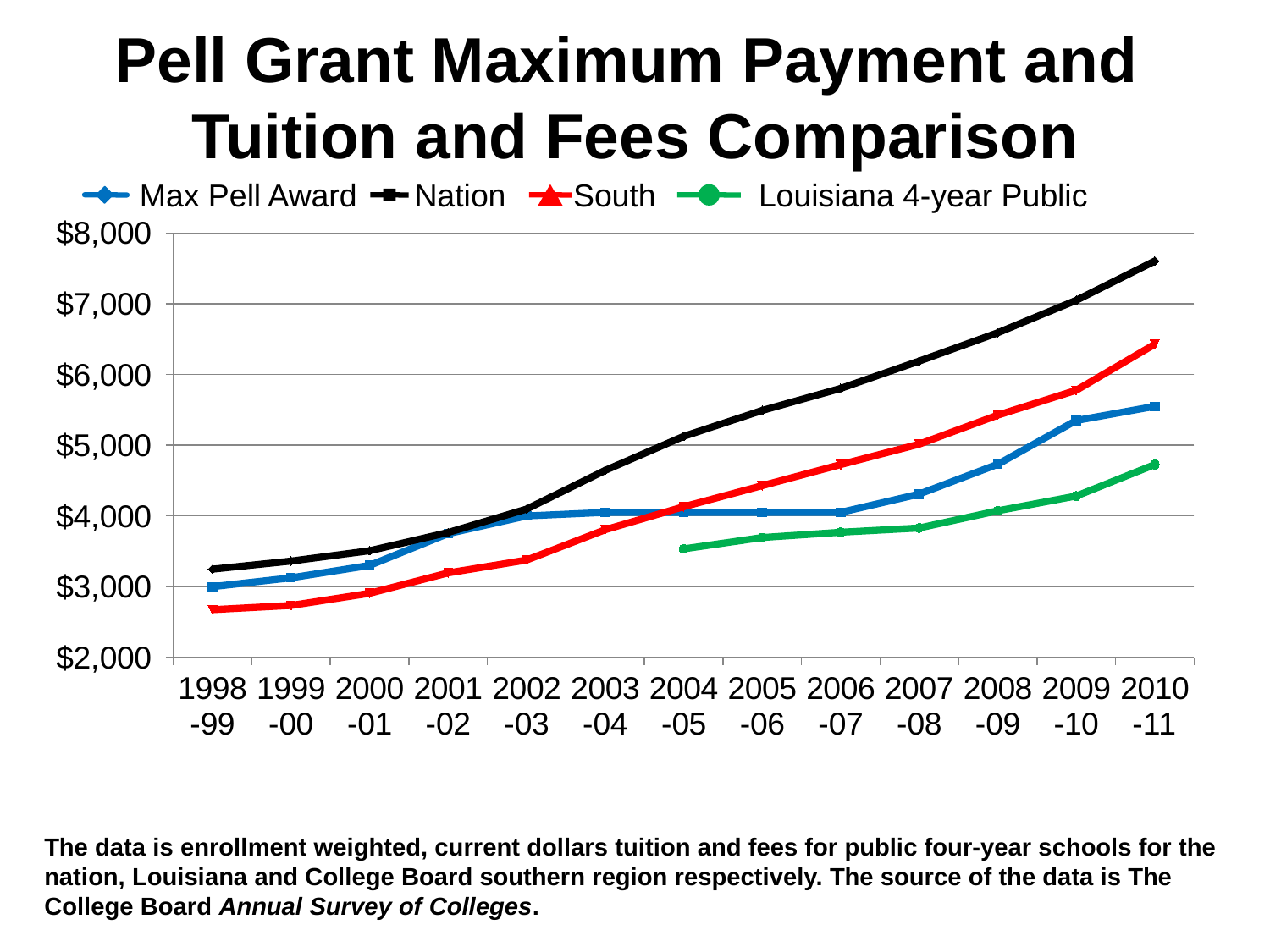
Is the value for Max Pell Award in 2010-11 greater or less than $5,000? greater Is the value for South in 1998-99 greater or less than $3,000? less Which series has the lowest value in 2010-11? Louisiana 4-year Public Which series has the highest value in 2010-11? Nation In 2010-11, which is larger: South or Max Pell Award? South Which series has the lowest value in 1998-99? South Is the value for Louisiana 4-year Public in 2010-11 greater or less than $5,000? less Does the Nation series rise or fall from 1998-99 to 2010-11? rise What kind of chart is shown on the slide? line chart How many series does the legend list? 4 How many academic years are shown along the x axis? 13